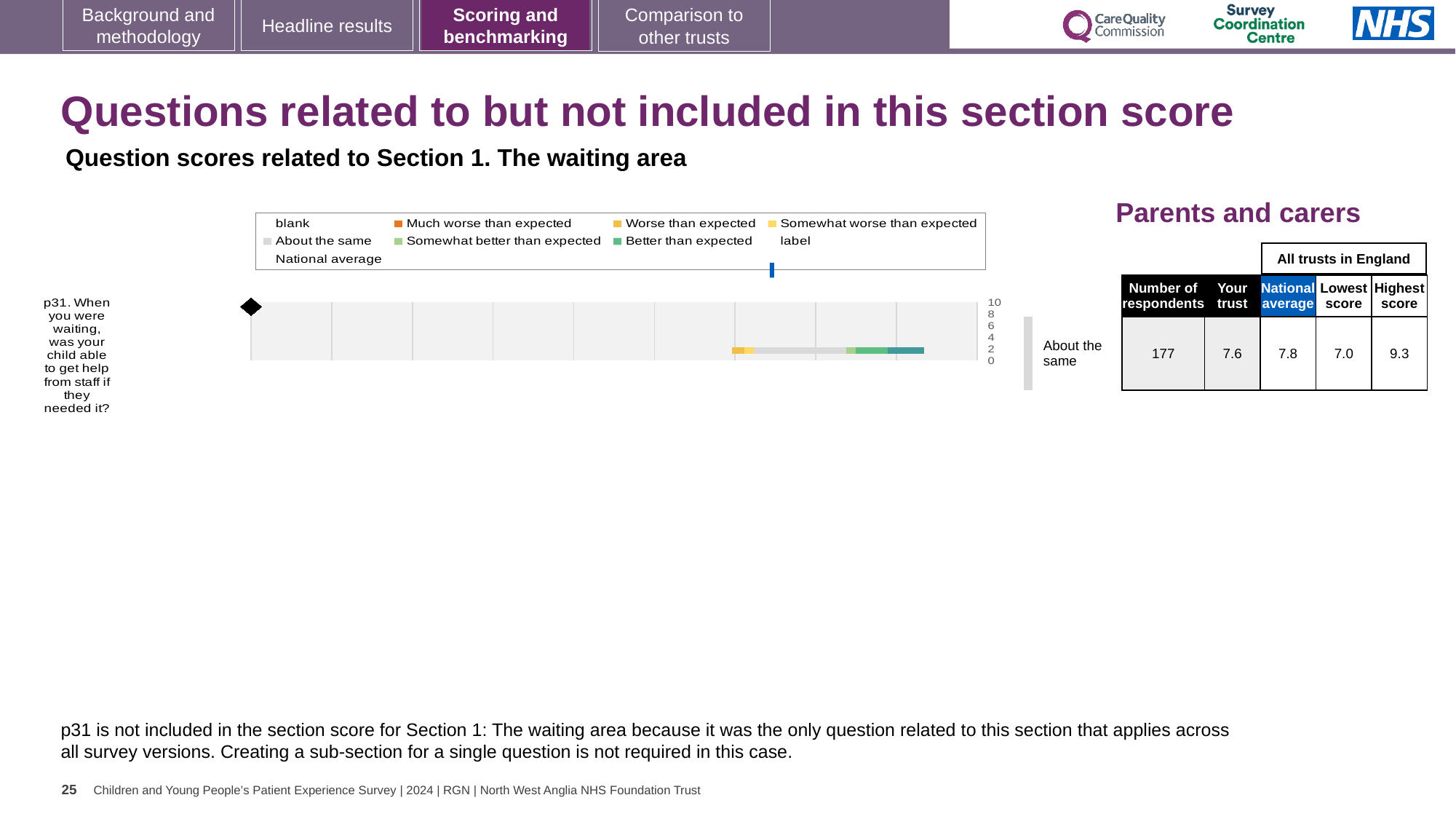
What kind of chart is shown for question p31? Bar chart In the table beside the chart, how many respondents answered p31? 177 In the table beside the chart, what is the 'Your trust' score for p31? 7.6 For p31, what is the difference between the highest score and the lowest score among all trusts in England? 2.3 How many survey questions are plotted in the chart? 1 In the table beside the chart, what is the national average score for p31? 7.8 Which question number is plotted in the chart? p31 What benchmark category label is shown next to the chart for p31? About the same What is the highest value shown on the chart's axis? 10 For p31, which is larger: the 'Your trust' score or the national average? National average In the table beside the chart, what is the lowest score among all trusts in England for p31? 7.0 In the table beside the chart, what is the highest score among all trusts in England for p31? 9.3